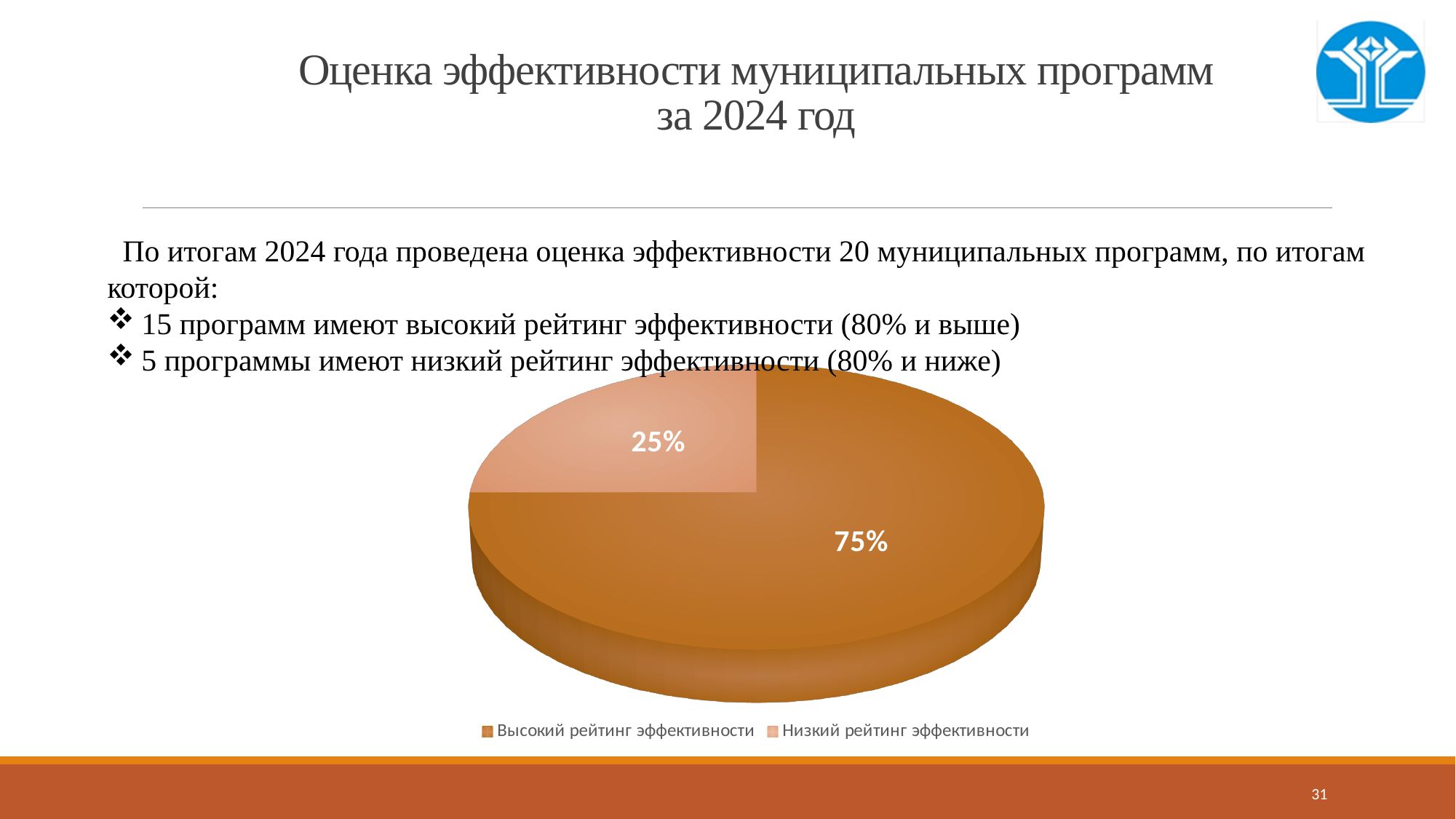
How many entries does the chart legend list? 2 What share of the pie does "Высокий рейтинг эффективности" have? 75% Which legend entry is shown in the lighter (pale orange) colour? Низкий рейтинг эффективности What is the difference in percentage points between the "Высокий рейтинг эффективности" slice and the "Низкий рейтинг эффективности" slice? 50 percentage points How many slices does the pie chart have? 2 Which slice of the pie chart is the largest? Высокий рейтинг эффективности What is the total of the two percentages shown on the pie chart? 100% Where is the legend positioned relative to the pie chart? Below the chart Which is larger: the "Высокий рейтинг эффективности" slice or the "Низкий рейтинг эффективности" slice? Высокий рейтинг эффективности What kind of chart is shown on the slide? Pie chart What share of the pie does "Низкий рейтинг эффективности" have? 25% Which slice of the pie chart is the smallest? Низкий рейтинг эффективности